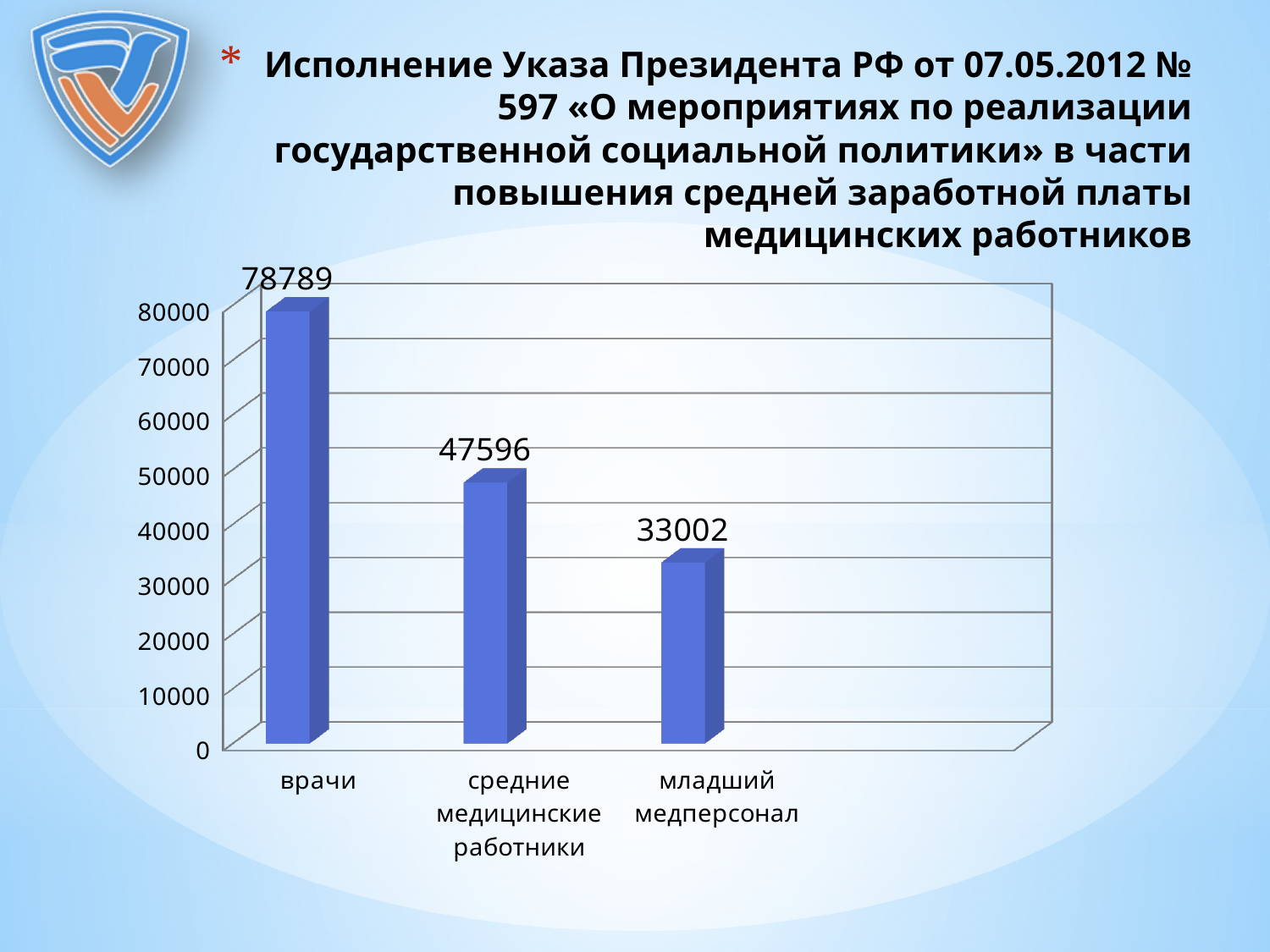
What is the value for врачи? 78789 What is the difference between the values for средние медицинские работники and младший медперсонал? 14594 Which category has the lowest value? младший медперсонал What kind of chart is shown on the slide? bar chart What is the value for средние медицинские работники? 47596 Which category has the highest value? врачи Do the values rise or fall from left to right along the x axis? fall Which is larger, the value for врачи or the value for младший медперсонал? врачи Is the value for средние медицинские работники greater or less than 40000? greater What is the difference between the values for врачи and средние медицинские работники? 31193 What is the value for младший медперсонал? 33002 How many categories are shown on the x axis? 3